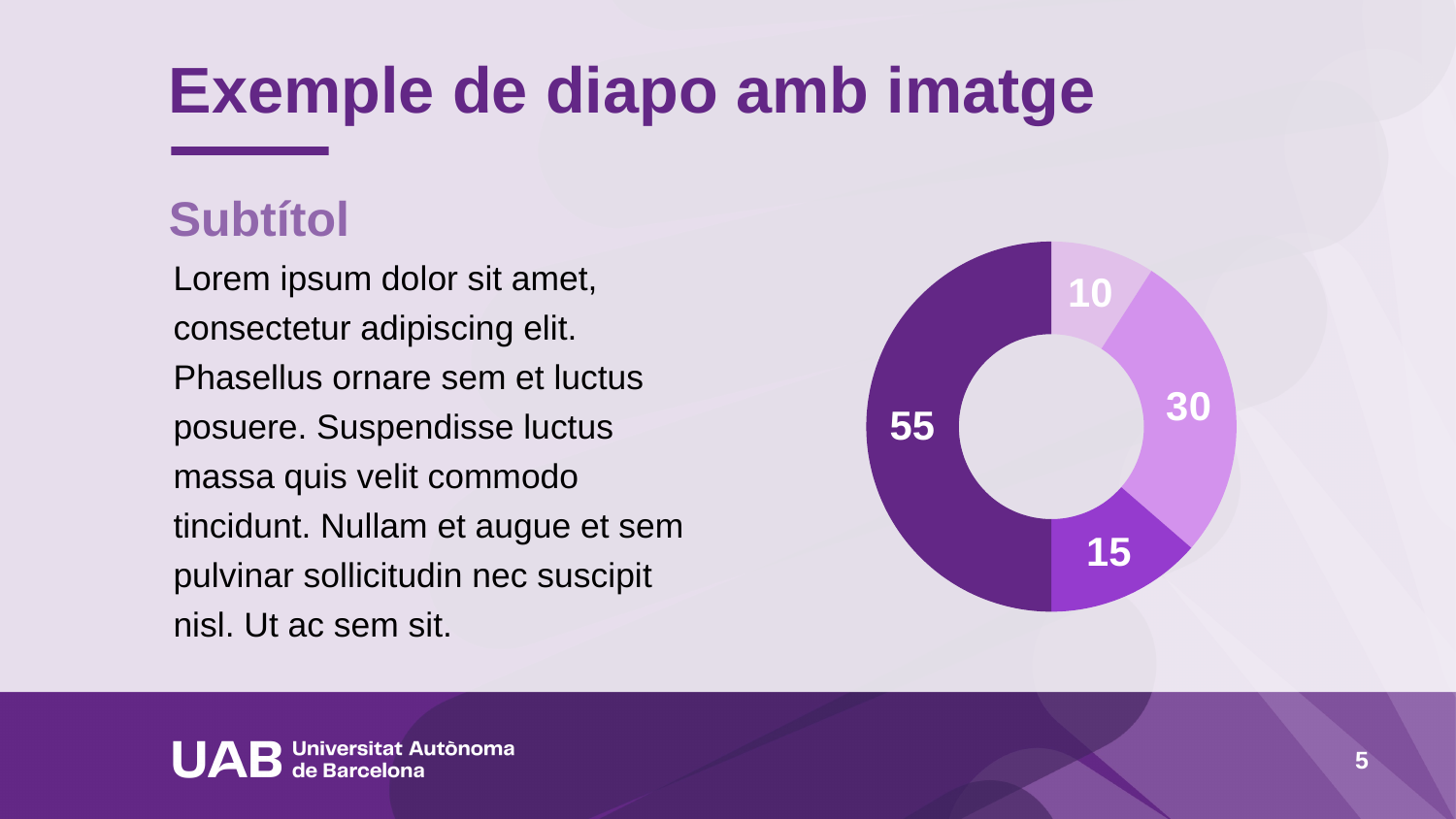
What is the difference between the largest and smallest slice values on the doughnut chart? 45 How many slices does the doughnut chart have? 4 What share of the whole doughnut does the slice labelled 55 represent? 50% What is the largest value shown on the doughnut chart? 55 What kind of chart is shown on the slide? doughnut (pie) chart Does the doughnut chart include a legend? No What is the difference between the slices labelled 30 and 15 on the doughnut chart? 15 Which is larger on the doughnut chart, the slice labelled 30 or the slice labelled 15? 30 What is the smallest value shown on the doughnut chart? 10 What value is shown on the darkest purple slice of the doughnut chart? 55 What value is shown on the lightest slice of the doughnut chart? 10 What is the sum of all the slice values shown on the doughnut chart? 110